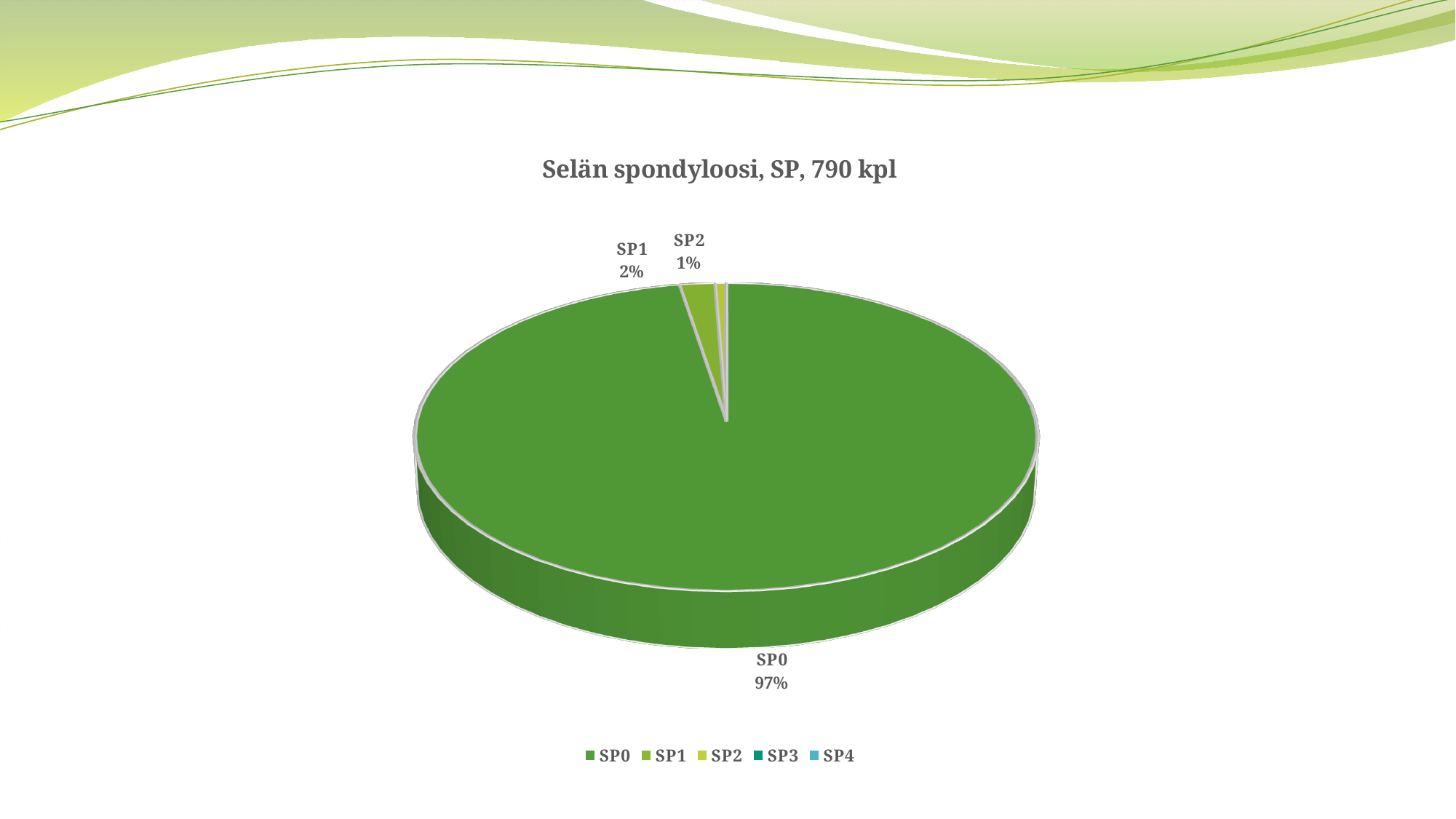
What kind of chart is shown on the slide? pie chart How many entries does the legend list? 5 Which of the labelled slices is the smallest? SP2 How many slices have a percentage label printed on the chart? 3 What share of the pie does SP0 have? 97% Which category has the largest slice of the pie? SP0 Which is larger, the slice for SP1 or the slice for SP2? SP1 What is the difference in percentage points between the SP0 slice and the SP1 slice? 95 What share of the pie does SP2 have? 1% What share of the pie does SP1 have? 2% What total number of cases (kpl) is stated in the chart title? 790 kpl What is the title of the chart? Selän spondyloosi, SP, 790 kpl